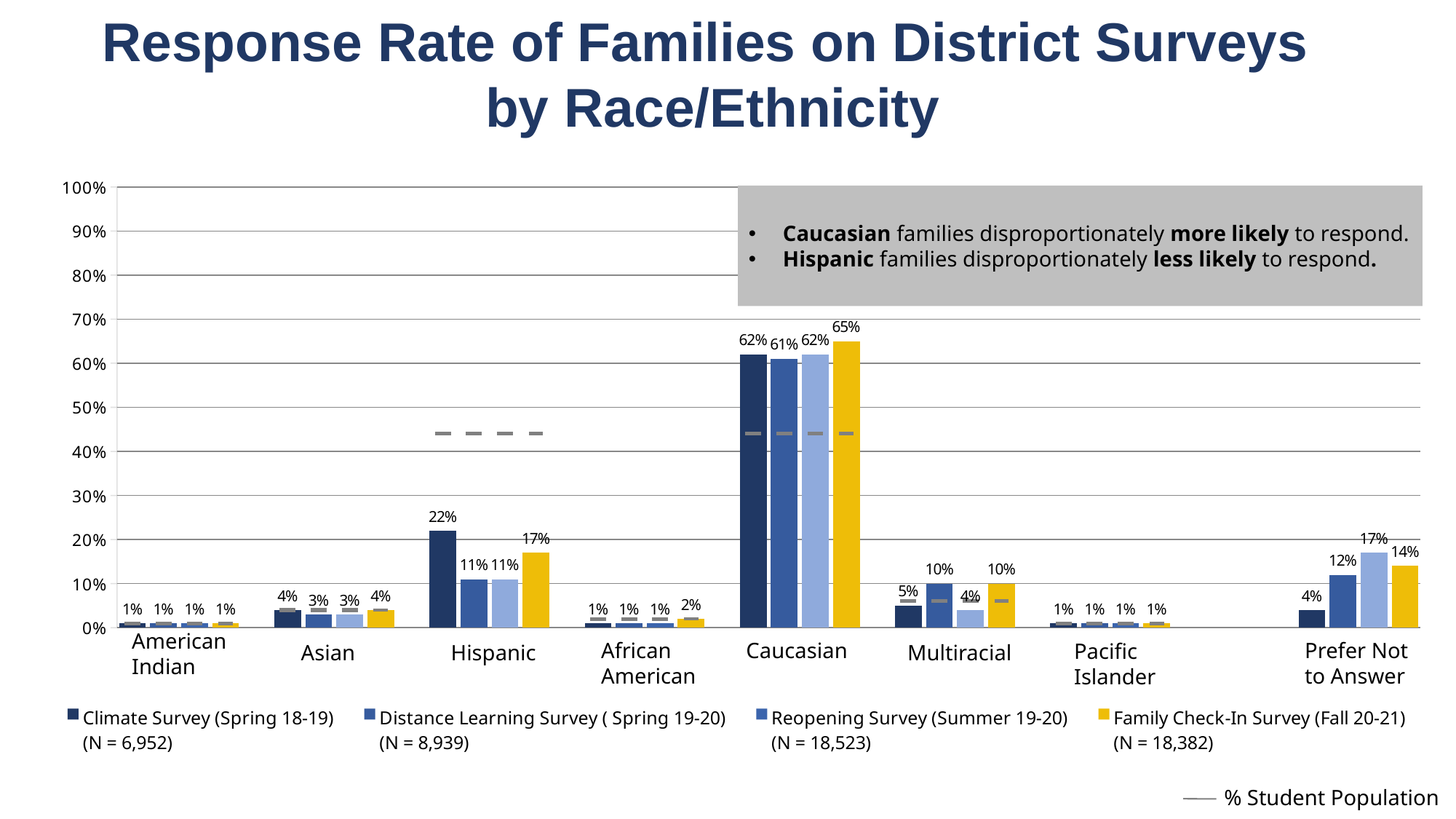
Which race/ethnicity category has the highest response rate on the Reopening Survey (Summer 19-20)? Caucasian How many percentage points higher is the Caucasian response rate on the Family Check-In Survey (Fall 20-21) than on the Climate Survey (Spring 18-19)? 3 percentage points What is the difference between the Hispanic response rate on the Climate Survey (Spring 18-19) and on the Distance Learning Survey (Spring 19-20)? 11 percentage points What is the Family Check-In Survey (Fall 20-21) response rate for Caucasian families? 65% What is the Reopening Survey (Summer 19-20) response rate for the Prefer Not to Answer category? 17% What is the title of the chart? Response Rate of Families on District Surveys by Race/Ethnicity For Hispanic families, which survey had the larger response rate: the Climate Survey (Spring 18-19) or the Family Check-In Survey (Fall 20-21)? Climate Survey (Spring 18-19) Is the Climate Survey (Spring 18-19) response rate for Caucasian families greater or less than 50%? greater What is the Climate Survey (Spring 18-19) response rate for Hispanic families? 22% What kind of chart is shown on the slide? Bar chart What is the Distance Learning Survey (Spring 19-20) response rate for Multiracial families? 10% How many race/ethnicity categories are shown on the x axis? 8